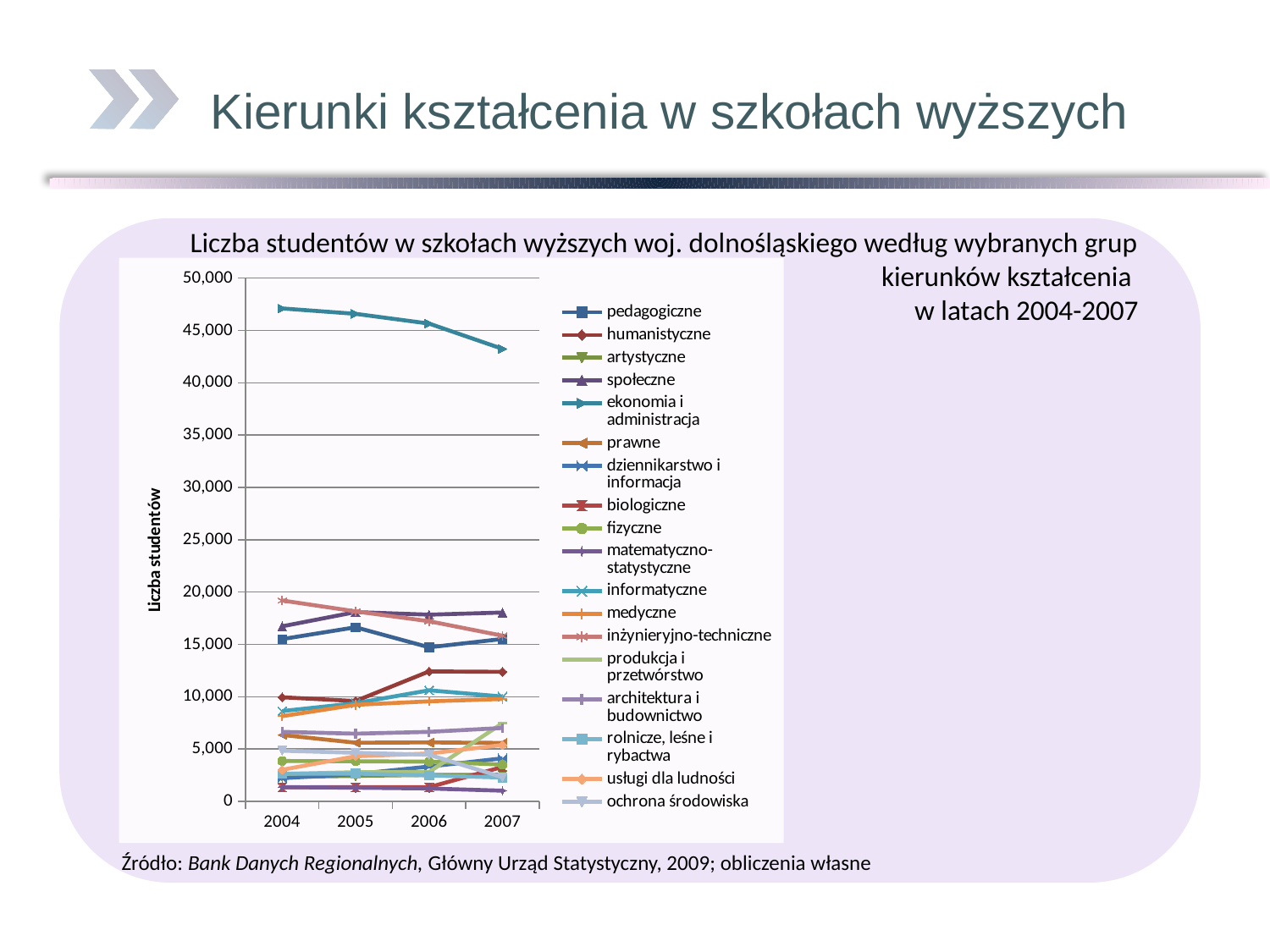
In 2007, which has more students: 'ekonomia i administracja' or 'pedagogiczne'? ekonomia i administracja How many years are shown on the x axis? 4 Does the number of students in 'inżynieryjno-techniczne' rise or fall from 2004 to 2007? fall Which group of study fields has the highest number of students across all years? ekonomia i administracja What is the label of the vertical axis? Liczba studentów What kind of chart is shown on the slide? line chart Does the number of students in 'ekonomia i administracja' rise or fall from 2004 to 2007? fall Is the value for 'inżynieryjno-techniczne' in 2004 greater or less than 15,000? greater In 2004, which has more students: 'społeczne' or 'humanistyczne'? społeczne Is the value for 'ekonomia i administracja' in 2007 greater or less than 45,000? less How many series does the legend list? 18 Is the value for 'ekonomia i administracja' in 2004 greater or less than 45,000? greater